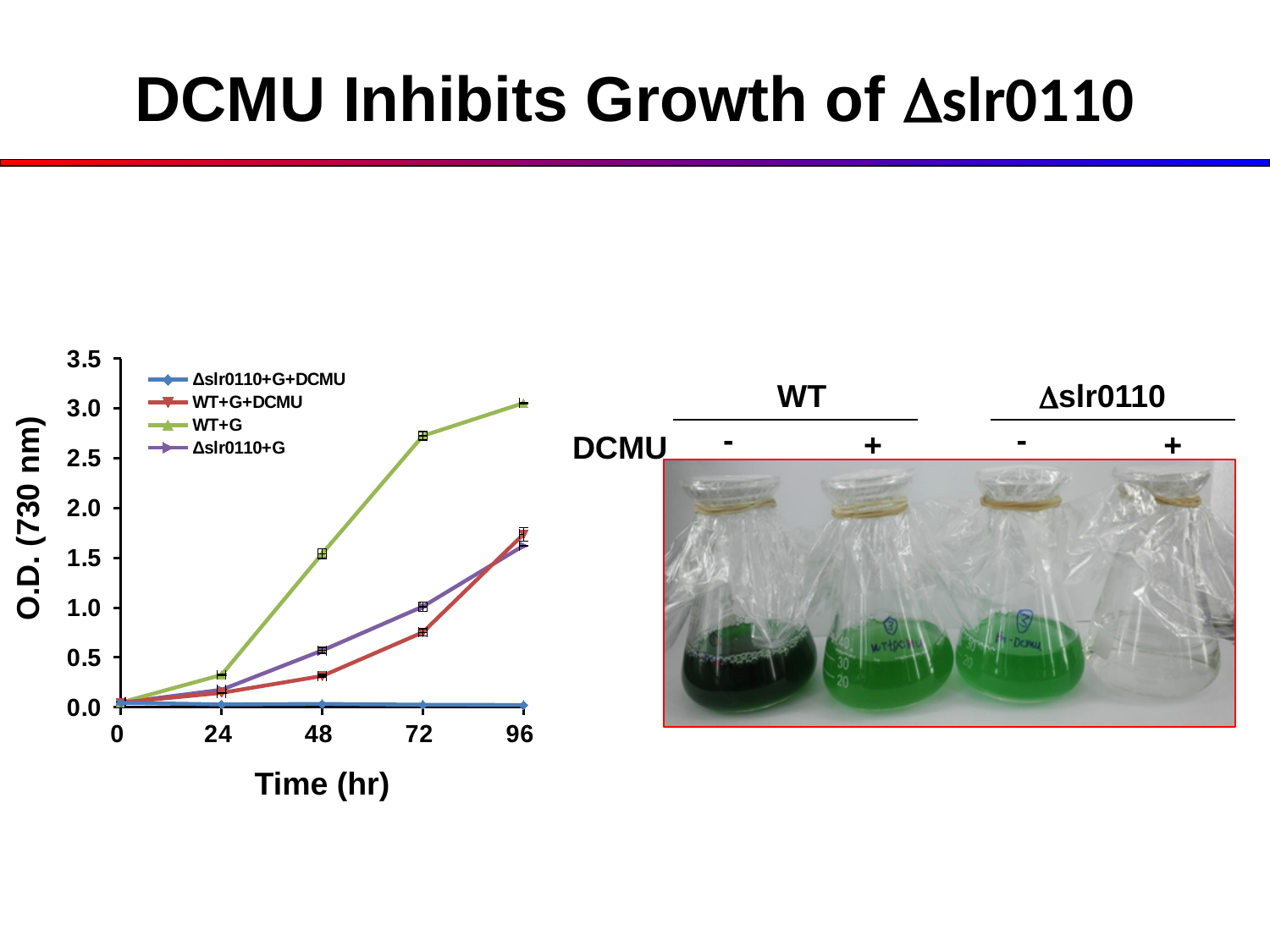
Does the O.D. for WT+G rise or fall from 0 hr to 96 hr? rise Which series has the highest O.D. at 96 hr? WT+G How many series does the chart legend list? 4 How many time points are plotted along the x axis of the chart? 5 What kind of chart is shown on the slide? line chart What is the title of the y axis of the chart? O.D. (730 nm) At 72 hr, which series has the higher O.D.: Δslr0110+G or WT+G+DCMU? Δslr0110+G Is the O.D. for Δslr0110+G+DCMU at 96 hr greater or less than 0.5? less Is the O.D. for WT+G at 24 hr greater or less than 0.5? less Which series has the lowest O.D. at 96 hr? Δslr0110+G+DCMU Is the O.D. for WT+G+DCMU at 72 hr greater or less than 0.5? greater